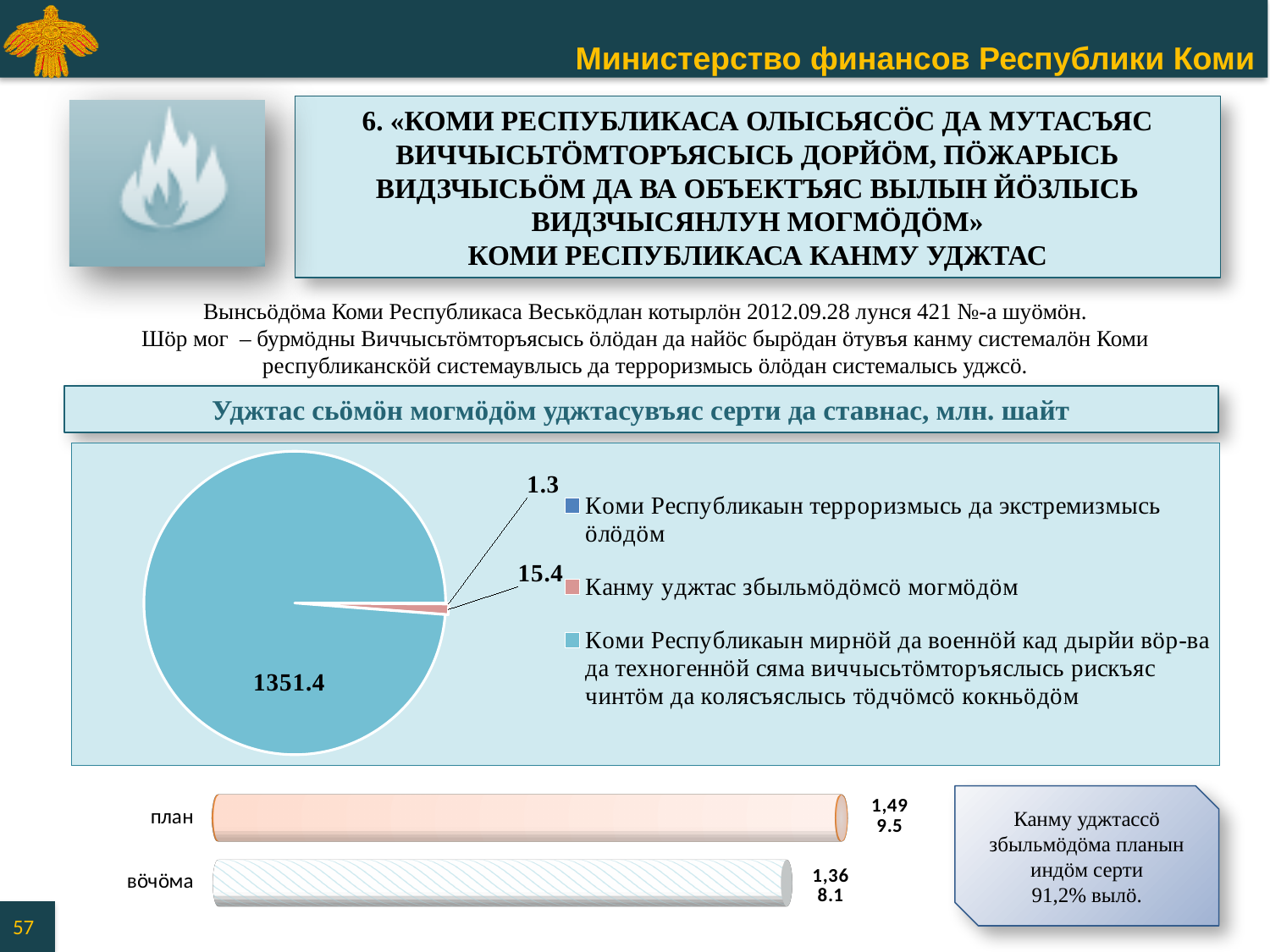
In the lower bar chart, what is the value for план? 1,499.5 In the lower bar chart, what is the value for вöчöма? 1,368.1 How many slices does the pie chart have? 3 What kind of chart is the upper chart on the slide? pie chart In the pie chart, which legend entry has the smallest value? Коми Республикаын терроризмысь да экстремизмысь öлöдöм In the pie chart, what is the value of the slice for «Канму уджтас збыльмöдöмсö могмöдöм»? 15.4 In the lower bar chart, which is larger, план or вöчöма? план In the pie chart, what is the total of all three slices? 1368.1 What kind of chart is the lower chart on the slide (план / вöчöма)? bar chart In the lower bar chart, what is the difference between план and вöчöма? 131.4 How many entries does the pie chart legend list? 3 In the pie chart, what is the value of the largest slice? 1351.4